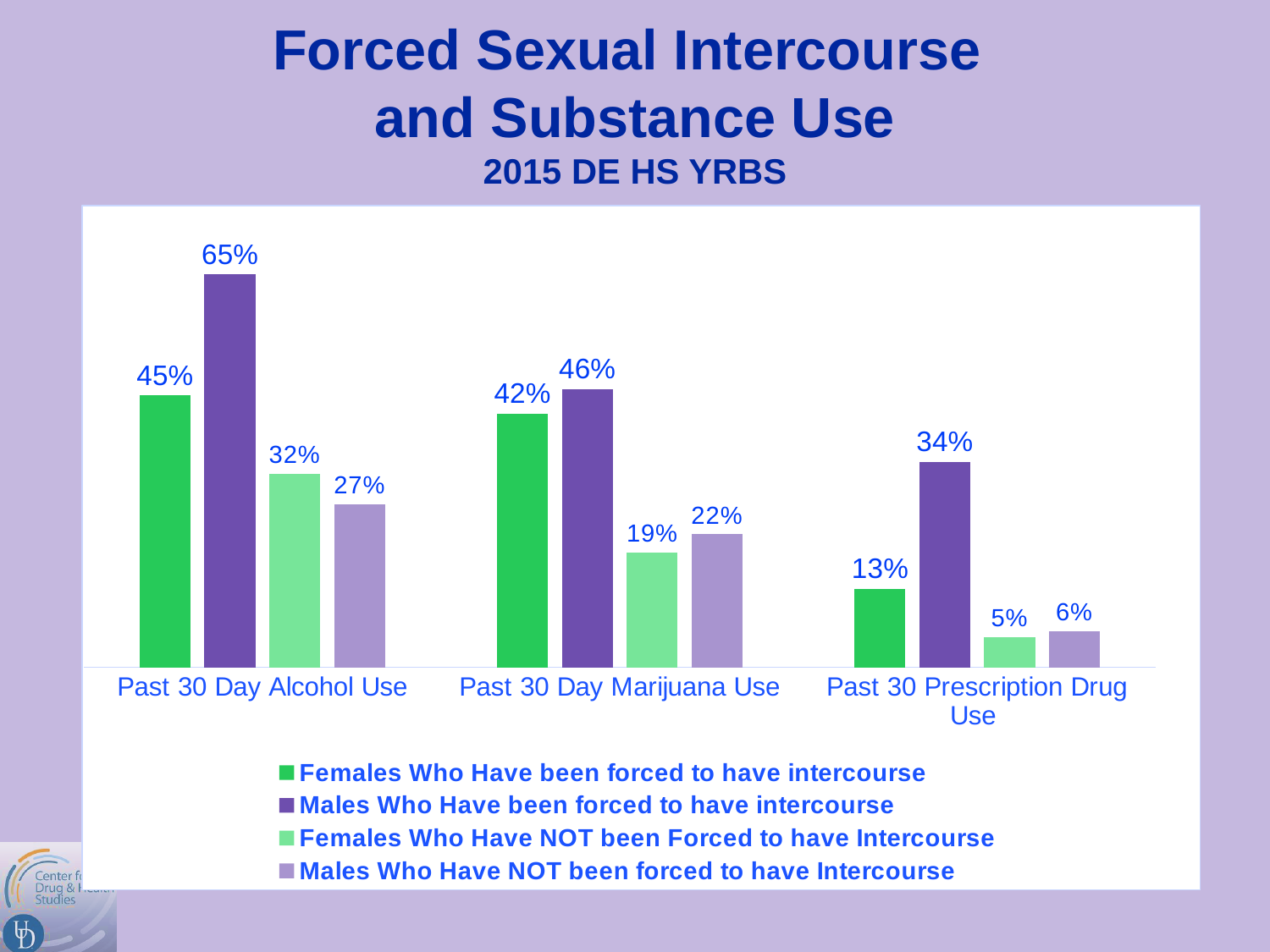
Which category has the highest value for Males Who Have been forced to have intercourse? Past 30 Day Alcohol Use What is the difference between Males Who Have been forced to have intercourse and Males Who Have NOT been forced to have Intercourse for Past 30 Day Alcohol Use? 38% What kind of chart is shown on the slide? Bar chart Which is larger for Past 30 Prescription Drug Use: Males Who Have been forced to have intercourse or Females Who Have been forced to have intercourse? Males Who Have been forced to have intercourse What is the value for Males Who Have been forced to have intercourse for Past 30 Day Alcohol Use? 65% What is the value for Males Who Have NOT been forced to have Intercourse for Past 30 Prescription Drug Use? 6% Which category has the lowest value for Females Who Have NOT been Forced to have Intercourse? Past 30 Prescription Drug Use How many categories are shown on the x axis? 3 What is the value for Females Who Have been forced to have intercourse for Past 30 Prescription Drug Use? 13% What is the difference between Females Who Have been forced to have intercourse and Females Who Have NOT been Forced to have Intercourse for Past 30 Day Marijuana Use? 23% What is the value for Females Who Have NOT been Forced to have Intercourse for Past 30 Day Marijuana Use? 19% How many series does the legend list? 4